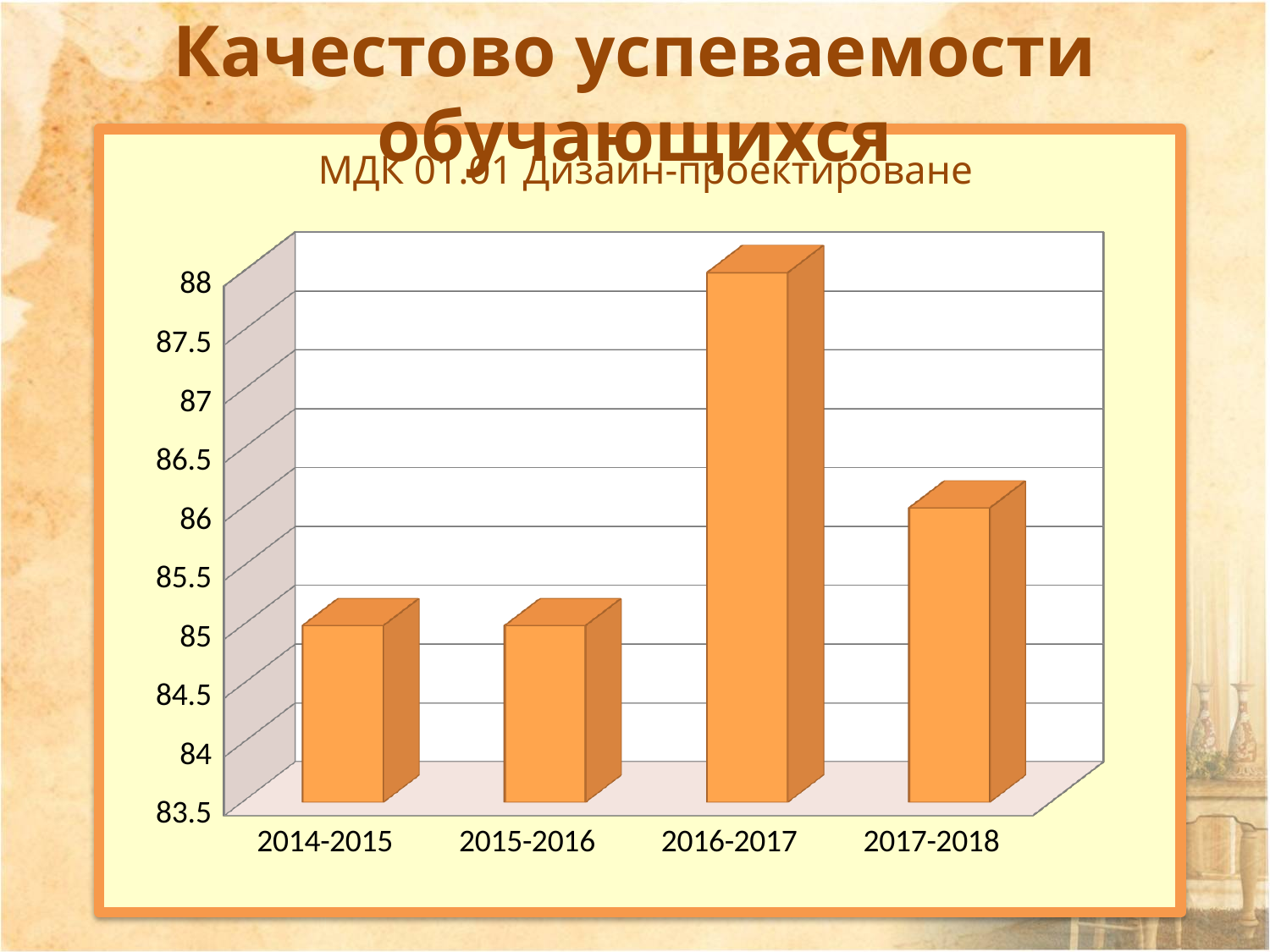
What is the title of the chart? МДК 01.01 Дизайн-проектироване What is the value for 2016-2017 in the chart? 88 Is the value for 2015-2016 greater or less than 84.5? greater Which academic year has the highest value in the chart? 2016-2017 Which is larger, the value for 2017-2018 or the value for 2014-2015? 2017-2018 What kind of chart is shown on the slide? bar chart Which is larger, the value for 2016-2017 or the value for 2017-2018? 2016-2017 How many academic years are shown on the x axis of the chart? 4 Is the value for 2014-2015 greater or less than 86? less Is the value for 2016-2017 greater or less than 87? greater Between 2016-2017 and 2017-2018, does the value rise or fall? fall